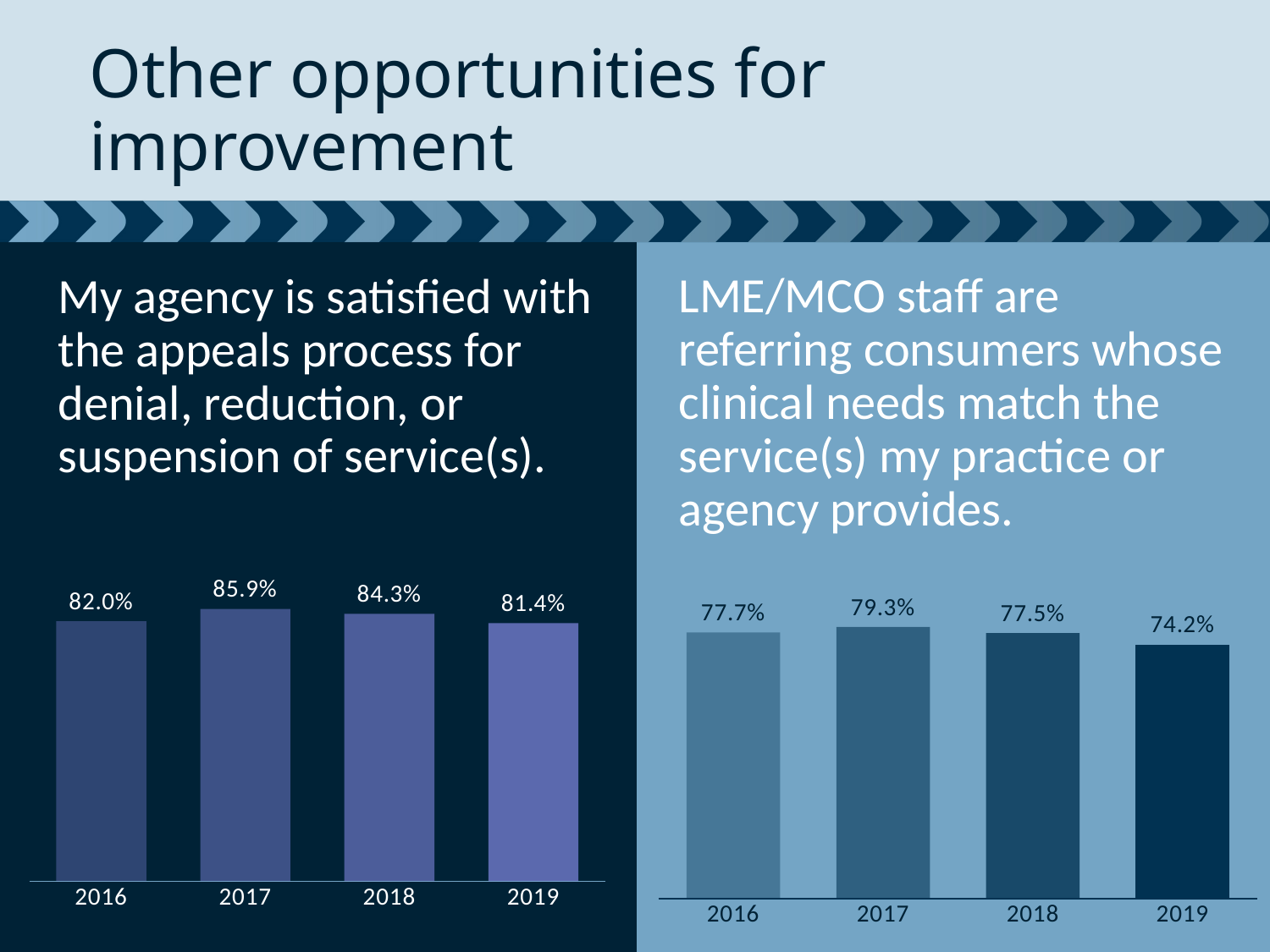
In the right chart (LME/MCO staff referring consumers), what is the difference between the 2017 and 2019 values? 5.1% What kind of chart is the right chart (LME/MCO staff referring consumers)? bar chart In the right chart (LME/MCO staff referring consumers), do the values rise or fall from 2017 to 2019? fall In the left chart (appeals process satisfaction), which is larger, the value for 2016 or the value for 2018? 2018 How many years are shown in the left chart (appeals process satisfaction)? 4 In the right chart (LME/MCO staff referring consumers), what is the value for 2019? 74.2% In the left chart (appeals process satisfaction), what is the value for 2017? 85.9% In the left chart (appeals process satisfaction), which year has the highest value? 2017 In the right chart (LME/MCO staff referring consumers), which is larger, the value for 2016 or the value for 2017? 2017 In the right chart (LME/MCO staff referring consumers), which year has the lowest value? 2019 In the left chart (appeals process satisfaction), what is the difference between the 2017 and 2019 values? 4.5% In the left chart (appeals process satisfaction), what is the value for 2016? 82.0%